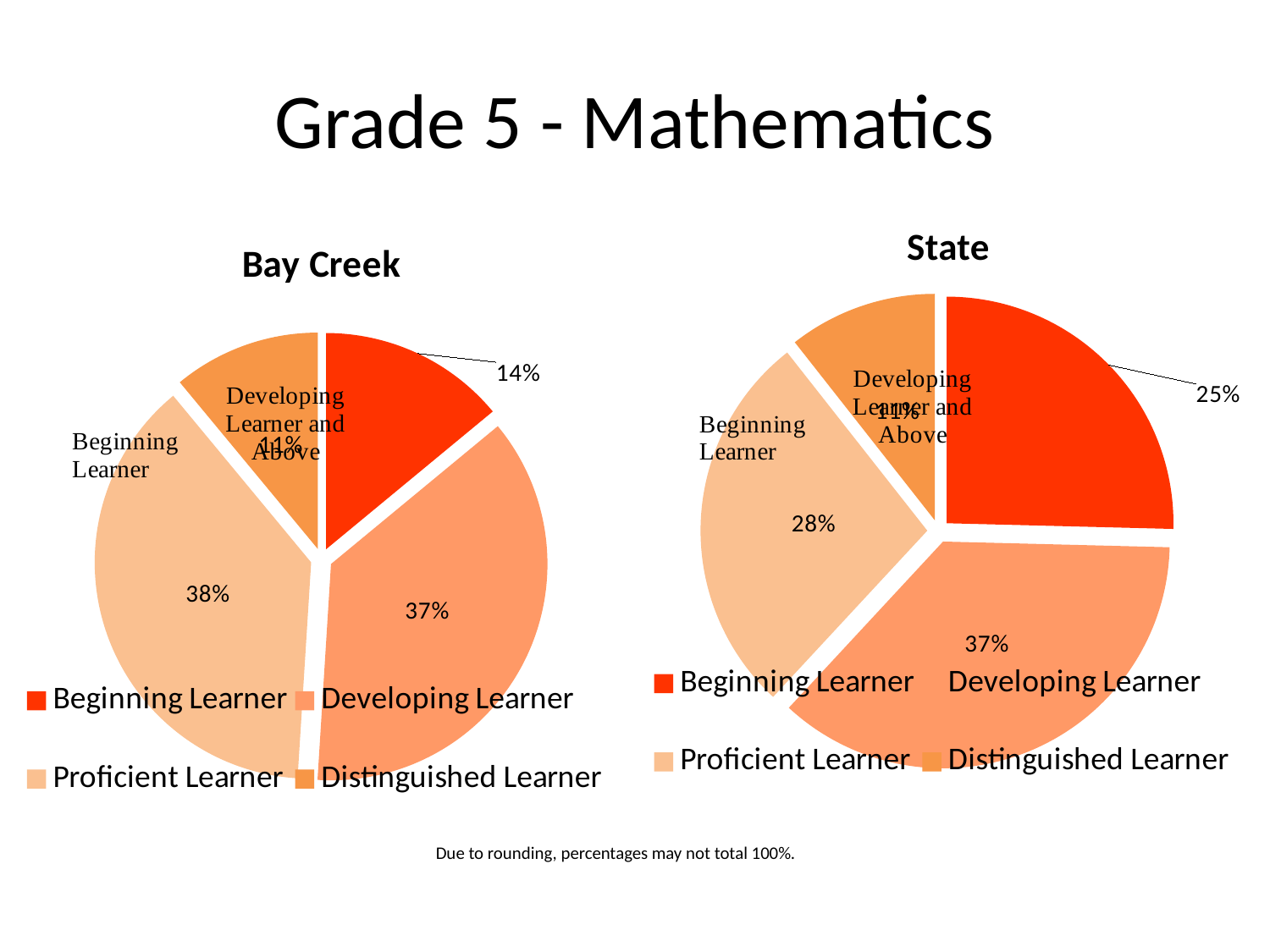
On the Bay Creek chart, which category has the smallest share? Distinguished Learner How many categories does the legend of the Bay Creek chart list? 4 On the Bay Creek chart, what percentage is shown for Beginning Learner? 14% What type of chart is used for Bay Creek and State? Pie chart On the State chart, which category has the largest share? Developing Learner Which is larger: Proficient Learner on the Bay Creek chart or Proficient Learner on the State chart? Bay Creek On the Bay Creek chart, what percentage is shown for Proficient Learner? 38% On the State chart, what percentage is shown for Beginning Learner? 25% On the State chart, what percentage is shown for Distinguished Learner? 11% What is the difference between the Beginning Learner percentage on the State chart and on the Bay Creek chart? 11% On the State chart, what percentage is shown for Proficient Learner? 28% What is the title of the slide? Grade 5 - Mathematics